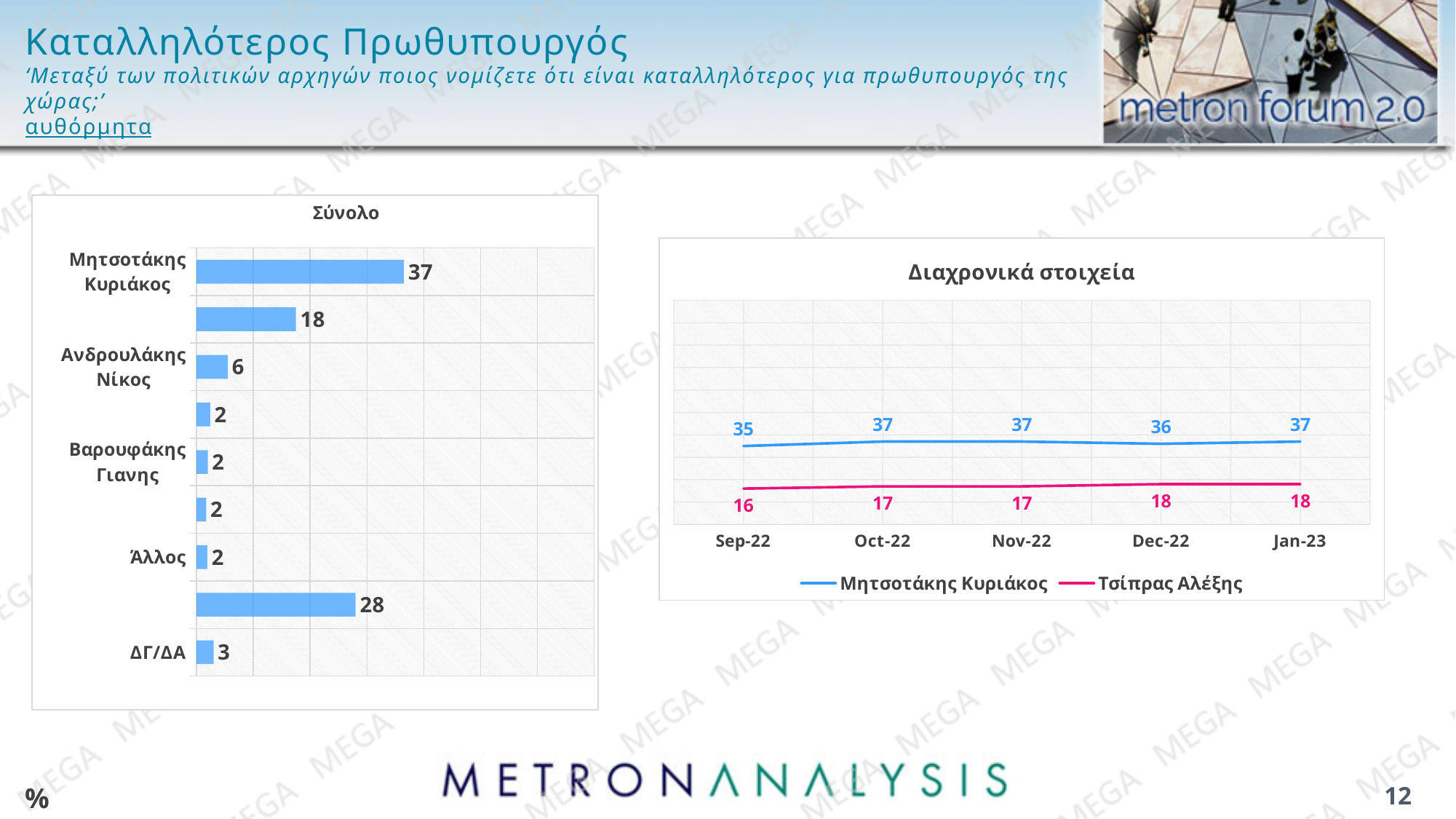
What kind of chart is the 'Σύνολο' chart? Bar chart In the 'Σύνολο' chart, what is the value for ΔΓ/ΔΑ? 3 In the 'Διαχρονικά στοιχεία' chart, what is the value for Μητσοτάκης Κυριάκος in Sep-22? 35 In the 'Διαχρονικά στοιχεία' chart, what is the value for Τσίπρας Αλέξης in Jan-23? 18 How many series does the legend of the 'Διαχρονικά στοιχεία' chart list? 2 In the 'Σύνολο' chart, which labelled category has the highest value? Μητσοτάκης Κυριάκος In the 'Διαχρονικά στοιχεία' chart, what is the difference between Μητσοτάκης Κυριάκος and Τσίπρας Αλέξης in Dec-22? 18 In the 'Σύνολο' chart, what is the value for Μητσοτάκης Κυριάκος? 37 In the 'Σύνολο' chart, how many bars are plotted? 9 In the 'Σύνολο' chart, what is the difference between the values for Μητσοτάκης Κυριάκος and Ανδρουλάκης Νίκος? 31 In the 'Διαχρονικά στοιχεία' chart, does the value for Τσίπρας Αλέξης rise or fall from Sep-22 to Jan-23? Rise In the 'Σύνολο' chart, what is the value for Ανδρουλάκης Νίκος? 6